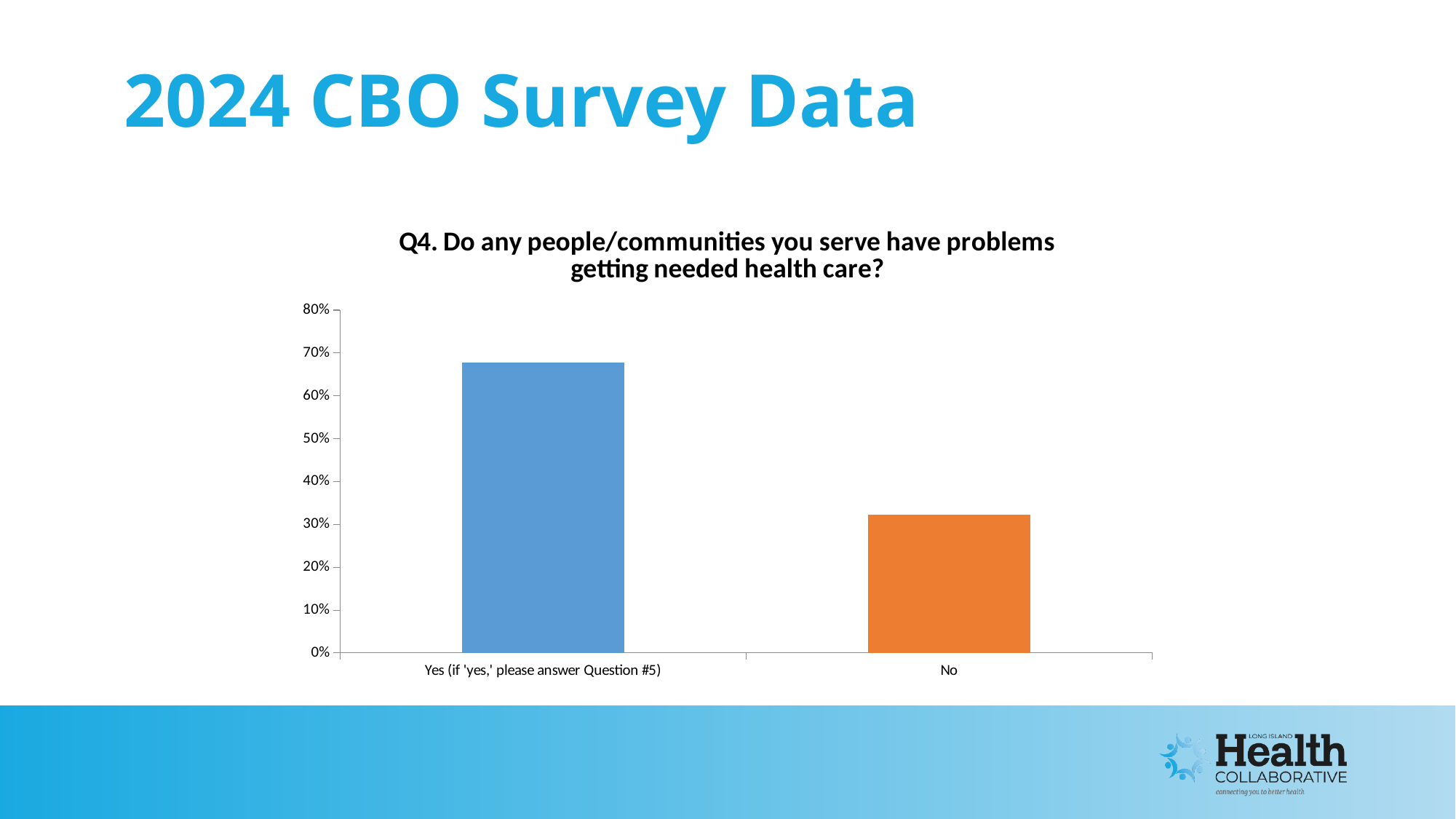
What colour is the bar for 'No'? orange What is the title of the chart? Q4. Do any people/communities you serve have problems getting needed health care? Which category has the lowest value in the chart? No What kind of chart is shown on the slide? bar chart Is the value for 'Yes' greater or less than 60%? greater Is the value for 'Yes' greater or less than 70%? less Which category has the highest value in the chart? Yes (if 'yes,' please answer Question #5) How many categories are shown on the x axis of the chart? 2 Which is larger, the value for 'Yes' or the value for 'No'? Yes What is the highest value shown on the y axis of the chart? 80% Is the value for 'No' greater or less than 30%? greater